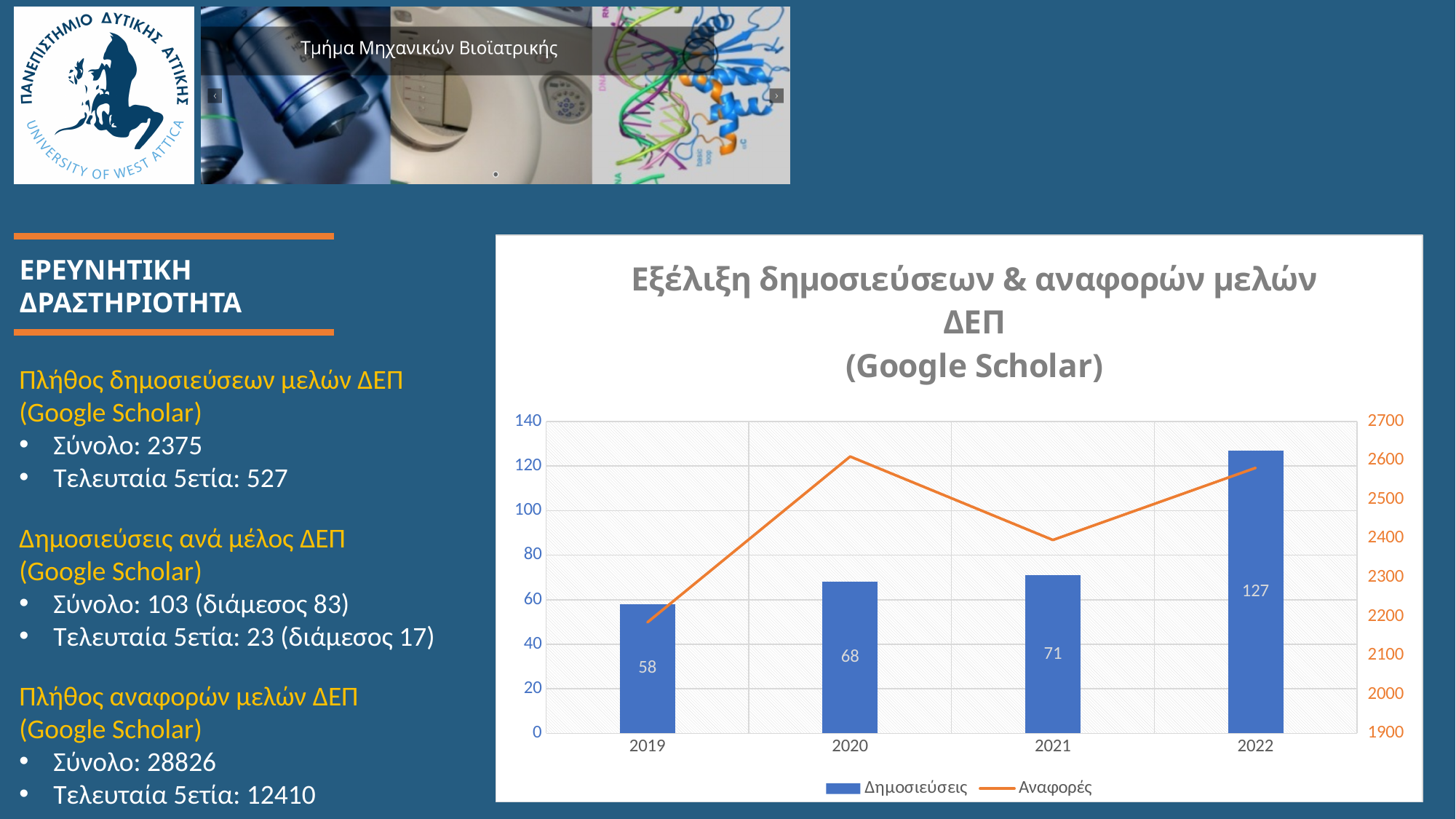
Which year has the lowest value of Δημοσιεύσεις? 2019 What is the value of Δημοσιεύσεις for 2021? 71 Which is larger, the Δημοσιεύσεις value for 2020 or for 2021? 2021 Do the Δημοσιεύσεις values rise or fall from 2019 to 2022? rise What is the value of Δημοσιεύσεις for 2019? 58 Is the Αναφορές value for 2019 greater or less than 2300? less How many series does the chart legend list? 2 What is the difference between the Δημοσιεύσεις values for 2022 and 2021? 56 What is the value of Δημοσιεύσεις for 2022? 127 Is the Αναφορές value for 2020 greater or less than 2500? greater Which year has the highest value of Δημοσιεύσεις? 2022 How many years are shown on the x axis of the chart? 4